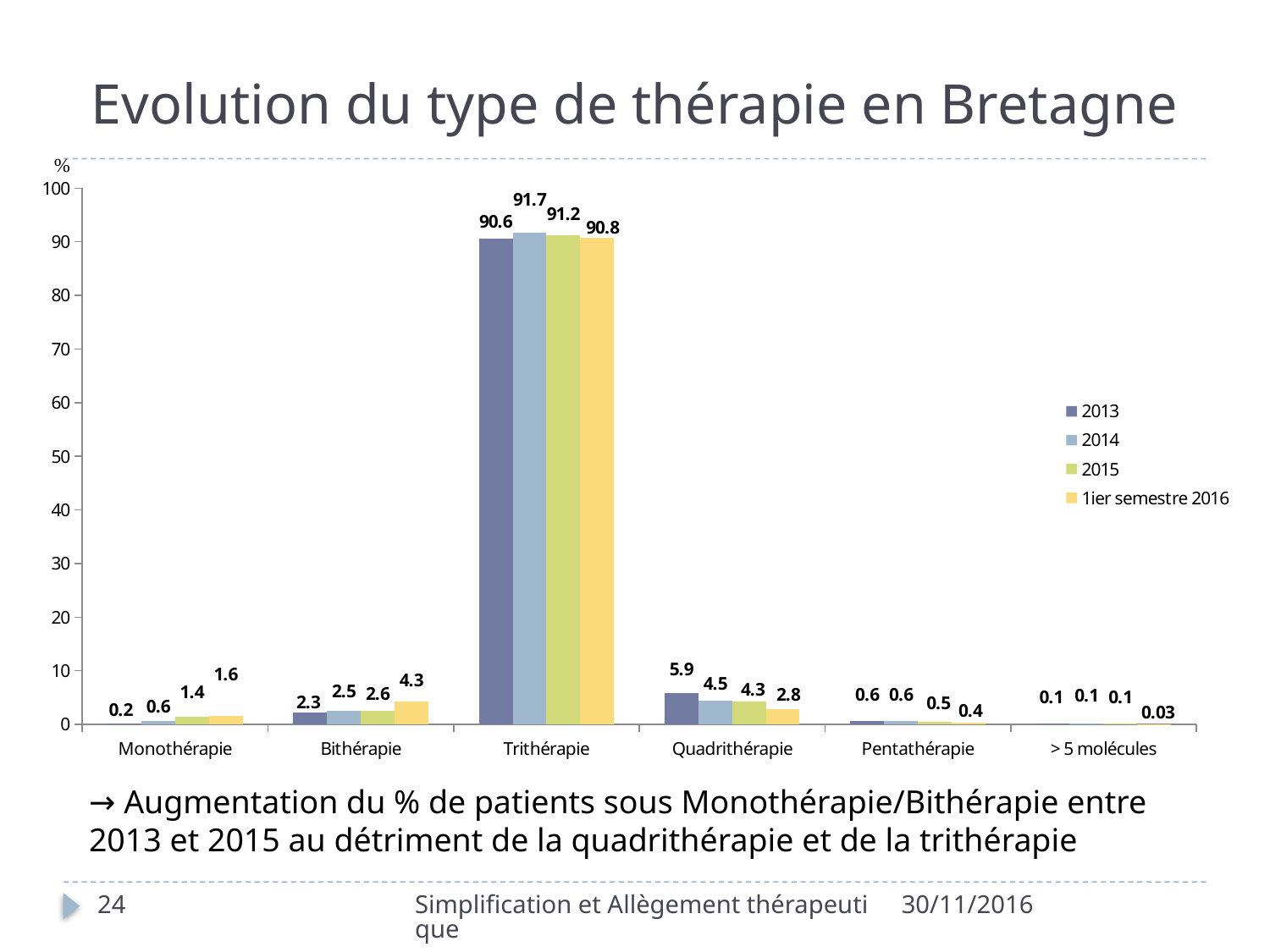
How many series does the legend list? 4 What is the value for Quadrithérapie in 2013? 5.9 Which is larger: the Bithérapie value for 2015 or for 1ier semestre 2016? 1ier semestre 2016 How many categories are shown on the x axis? 6 Is the value for Trithérapie in 2013 greater or less than 80? greater What is the difference between the Quadrithérapie values for 2013 and 1ier semestre 2016? 3.1 Which year has the lowest value for Monothérapie? 2013 What is the value for > 5 molécules in the 1ier semestre 2016 series? 0.03 What is the value for Bithérapie in the 1ier semestre 2016 series? 4.3 What is the value for Trithérapie in 2014? 91.7 Which category has the highest value in 2015? Trithérapie What kind of chart is shown on the slide? Bar chart